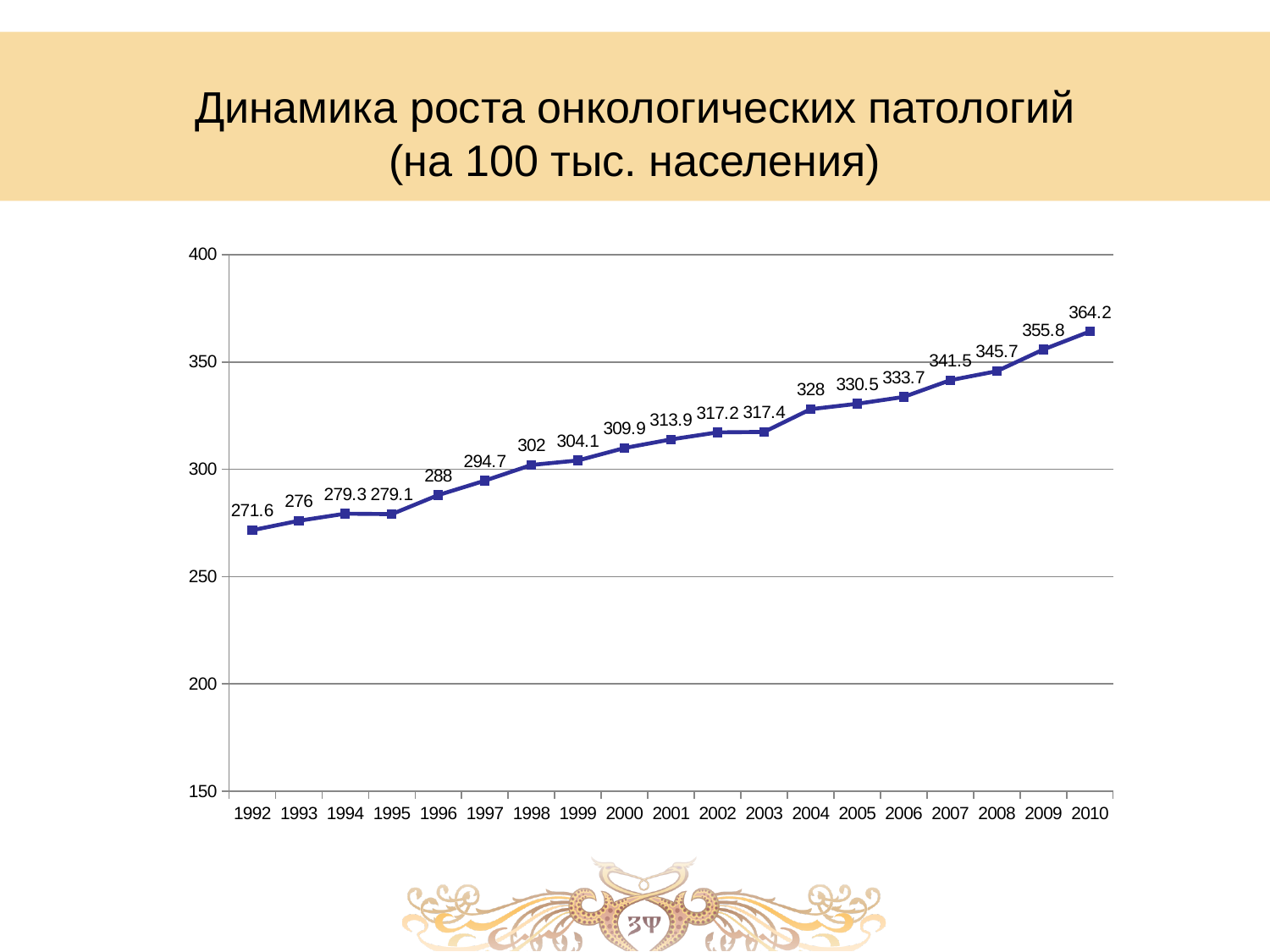
What is the difference between the values for 2010 and 1992? 92.6 What is the value for 1998? 302 What is the value for 2010? 364.2 Which year has the highest value? 2010 Do the values generally rise or fall from 1992 to 2010? rise How many years are plotted on the x axis? 19 Which is larger, the value for 1994 or the value for 1995? 1994 What is the value for 2004? 328 What kind of chart is shown on the slide? line chart Is the value for 2007 greater or less than 350? less What is the value for 1992? 271.6 Which year has the lowest value? 1992